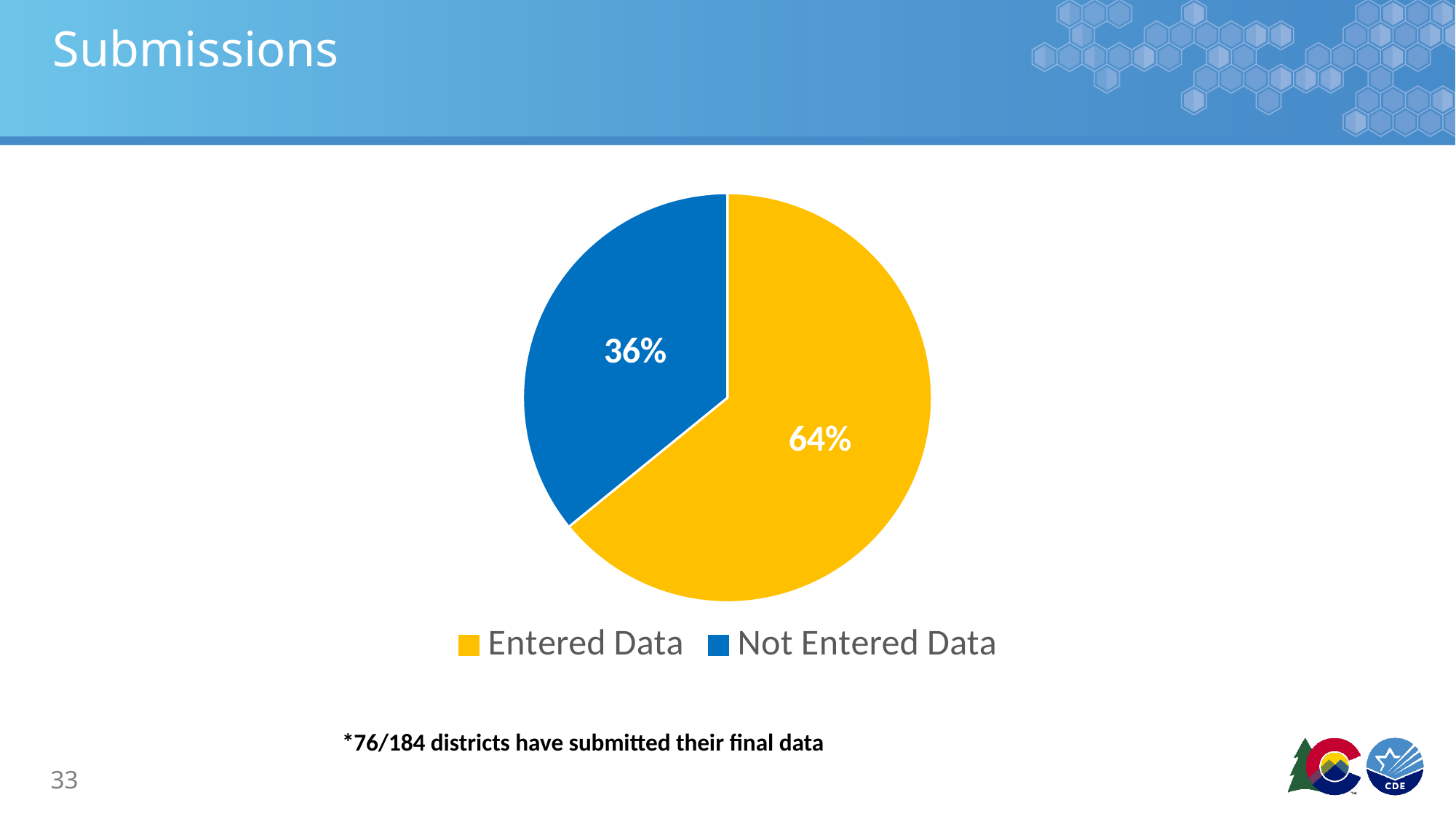
How many slices does the pie chart have? 2 Which is larger, the Entered Data slice or the Not Entered Data slice? Entered Data What colour is the Entered Data slice? yellow Which slice of the pie is the largest? Entered Data What percentage of the pie is labelled Entered Data? 64% What share of the pie does the Not Entered Data slice represent? 36% Which slice of the pie is the smallest? Not Entered Data What kind of chart is shown on the slide? pie chart How many entries does the legend list? 2 What percentage of the pie is labelled Not Entered Data? 36% What is the title of the slide containing the pie chart? Submissions What is the difference in percentage points between the Entered Data slice and the Not Entered Data slice? 28